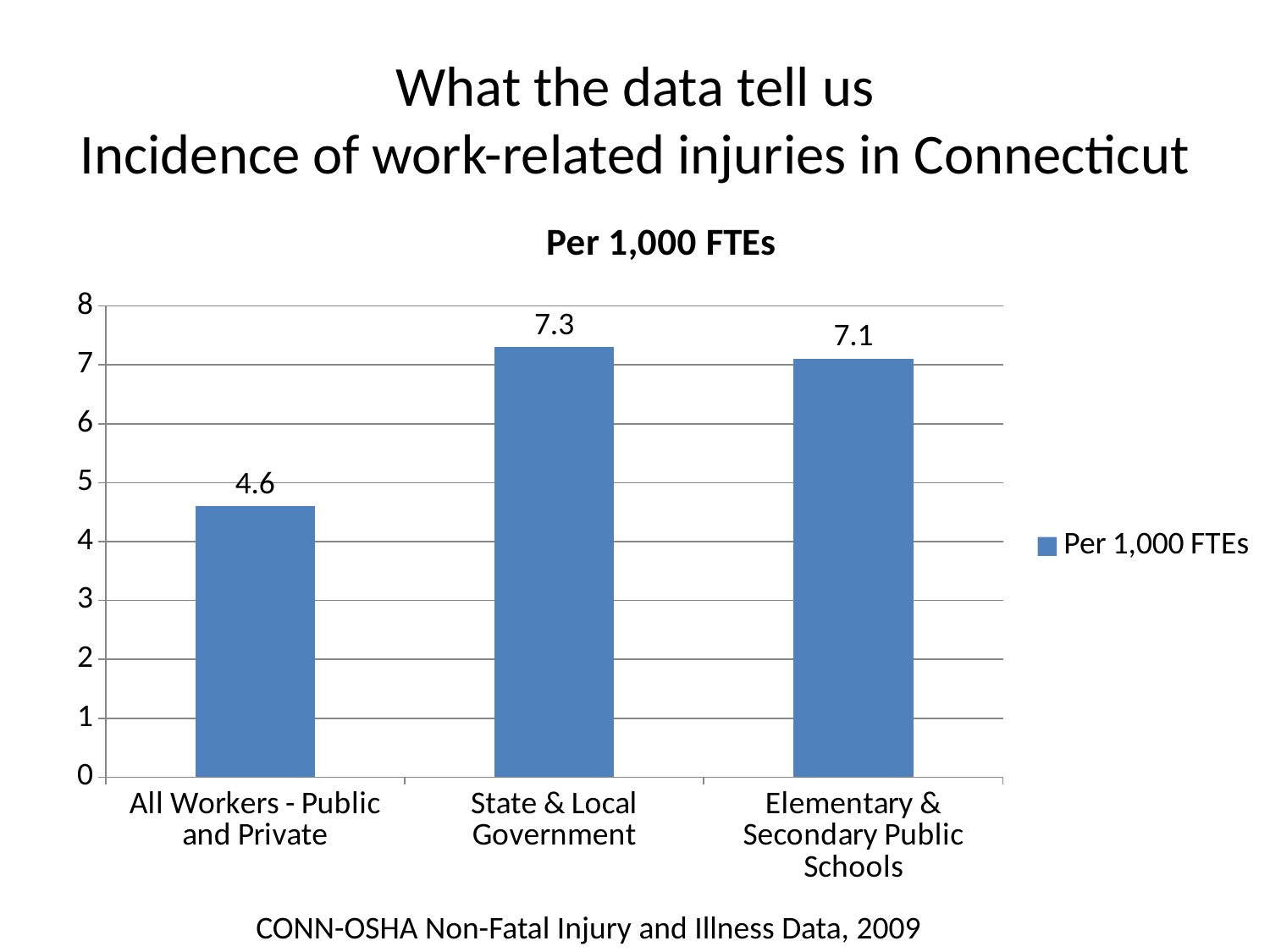
Is the value for All Workers - Public and Private greater or less than 5? less How many categories are shown on the chart? 3 Which category has the lowest value? All Workers - Public and Private What is the value for Elementary & Secondary Public Schools? 7.1 What is the value for State & Local Government? 7.3 What is the difference between the values for Elementary & Secondary Public Schools and All Workers - Public and Private? 2.5 What is the difference between the values for State & Local Government and All Workers - Public and Private? 2.7 What kind of chart is shown on the slide? bar chart Which category has the highest value? State & Local Government What is the title of the chart? Per 1,000 FTEs Which is larger, the value for State & Local Government or the value for All Workers - Public and Private? State & Local Government What is the value for All Workers - Public and Private? 4.6